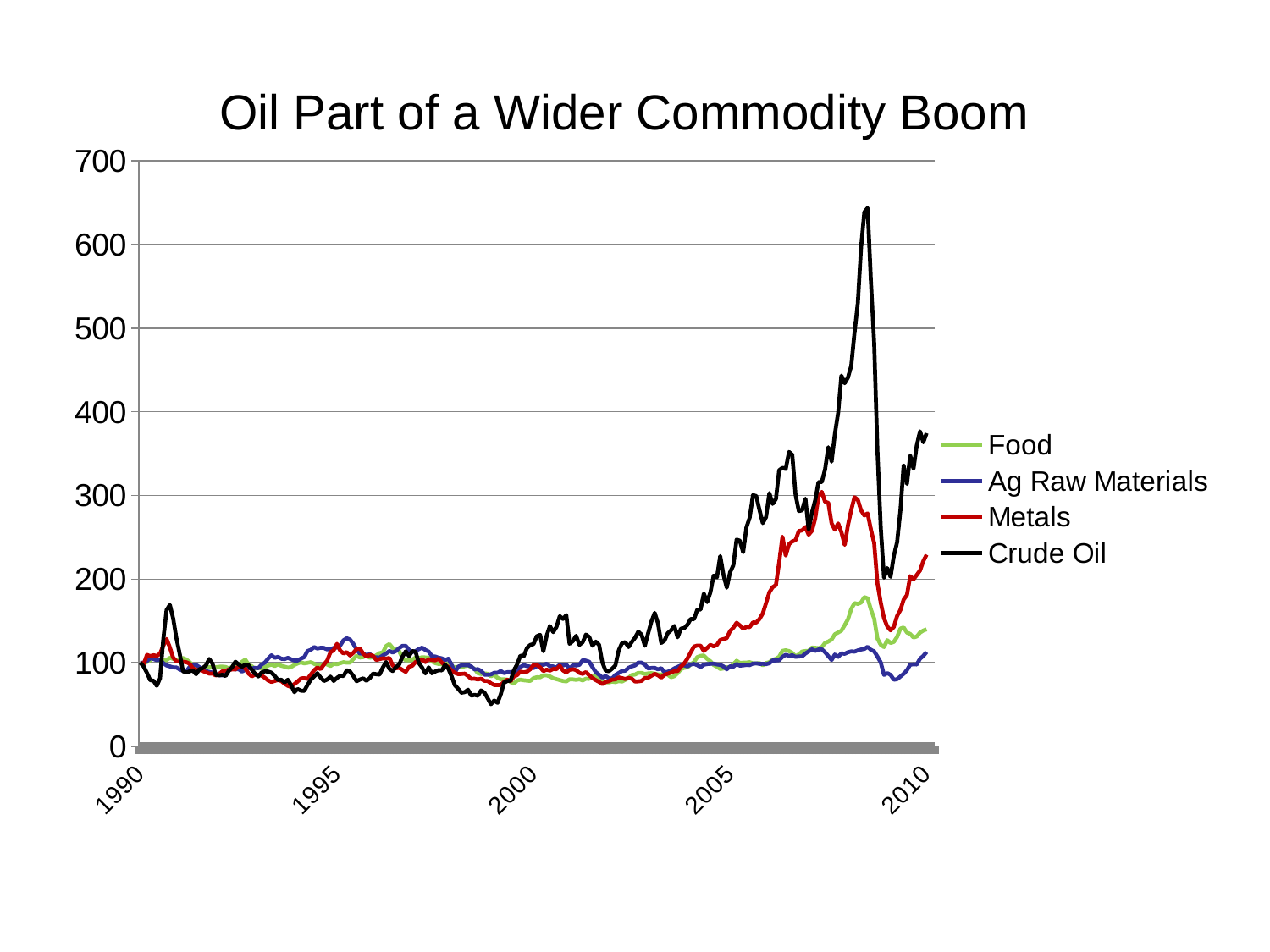
Does the Crude Oil series rise or fall between 2005 and 2008? rise Is the peak value of Crude Oil greater or less than 600? greater Is the highest value of Ag Raw Materials greater or less than 200? less Is the peak value of Metals greater or less than 400? less Which series has the lowest peak value on the chart? Ag Raw Materials How many series does the legend list? 4 What kind of chart is shown on the slide? line chart What is the title of the chart? Oil Part of a Wider Commodity Boom What colour is the Crude Oil line? black Around 2008, which series is higher, Metals or Ag Raw Materials? Metals Which series reaches the highest value on the chart? Crude Oil